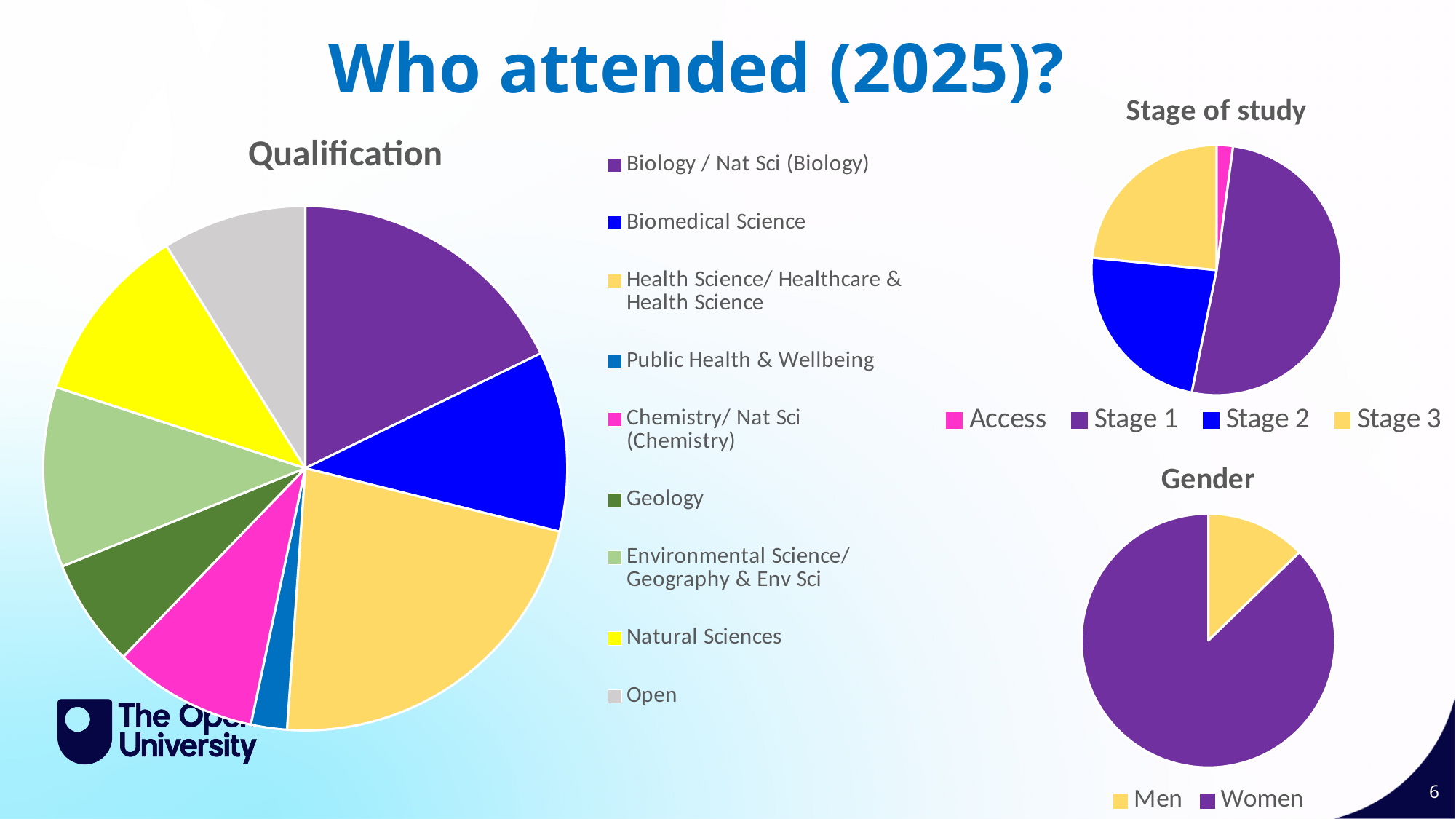
In the Stage of study pie chart, which slice is larger: Stage 1 or Stage 2? Stage 1 What colour represents Men in the Gender pie chart? yellow What kind of chart is the Qualification chart? pie chart In the Qualification pie chart, which slice is larger: Natural Sciences or Geology? Natural Sciences In the Gender pie chart, which group has the larger slice? Women How many categories does the Stage of study pie chart show? 4 In the Qualification pie chart, which category has the smallest slice? Public Health & Wellbeing How many categories does the Qualification pie chart show? 9 In the Stage of study pie chart, which stage has the largest slice? Stage 1 In the Qualification pie chart, which category has the largest slice? Health Science/ Healthcare & Health Science In the Stage of study pie chart, which category has the smallest slice? Access In the Qualification pie chart, which slice is larger: Environmental Science/ Geography & Env Sci or Geology? Environmental Science/ Geography & Env Sci